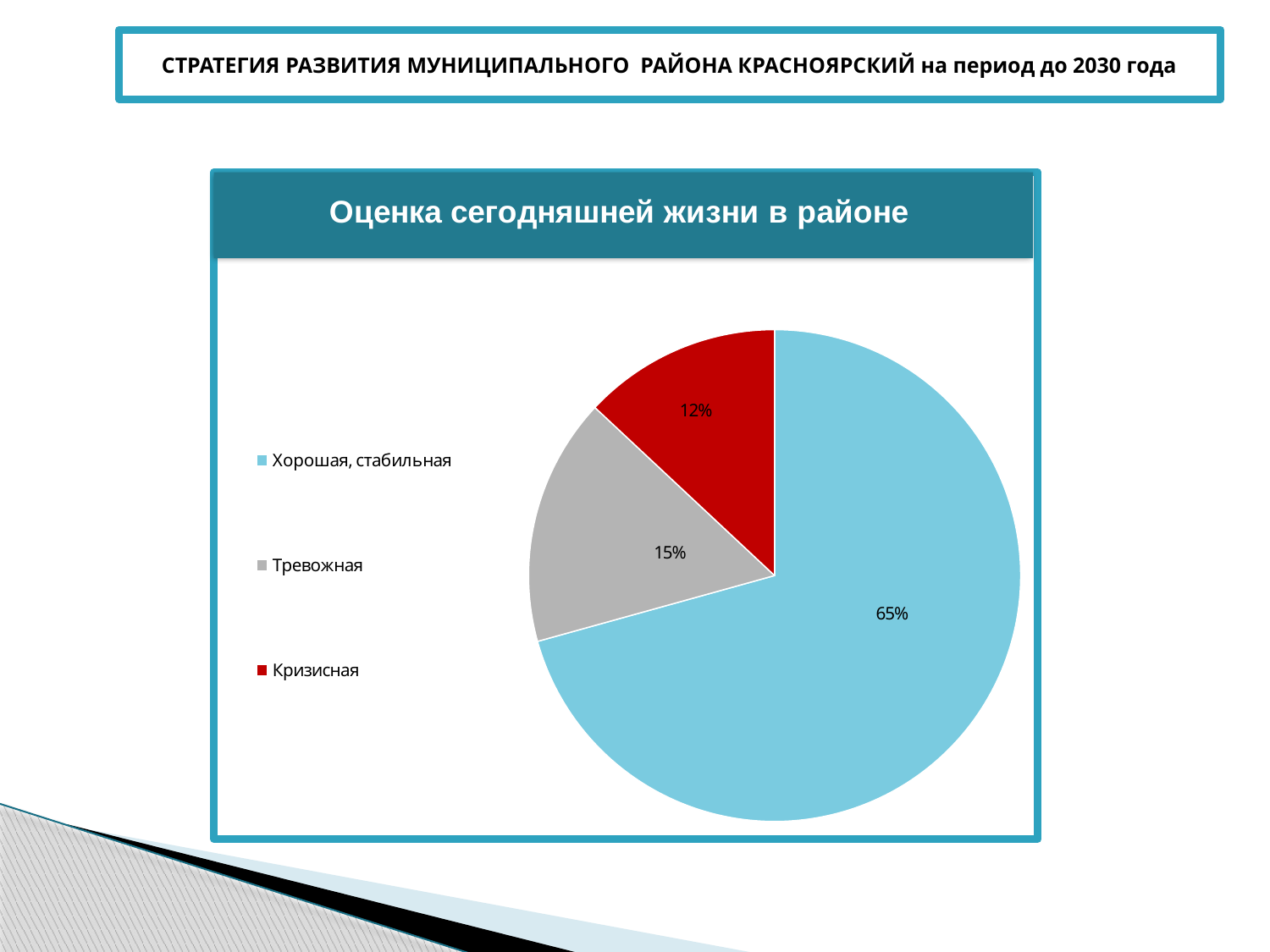
What is the difference between the shares for "Хорошая, стабильная" and "Тревожная"? 50% How many categories does the pie chart show? 3 What is the title of the chart? Оценка сегодняшней жизни в районе What colour is the slice for "Кризисная"? red What share of the pie is labelled "Хорошая, стабильная"? 65% Which category has the largest slice of the pie? Хорошая, стабильная What share of the pie is labelled "Тревожная"? 15% What kind of chart is shown on the slide? pie chart Which category has the smallest slice of the pie? Кризисная Which is larger, the share for "Тревожная" or the share for "Кризисная"? Тревожная What is the difference between the shares for "Тревожная" and "Кризисная"? 3% What share of the pie is labelled "Кризисная"? 12%